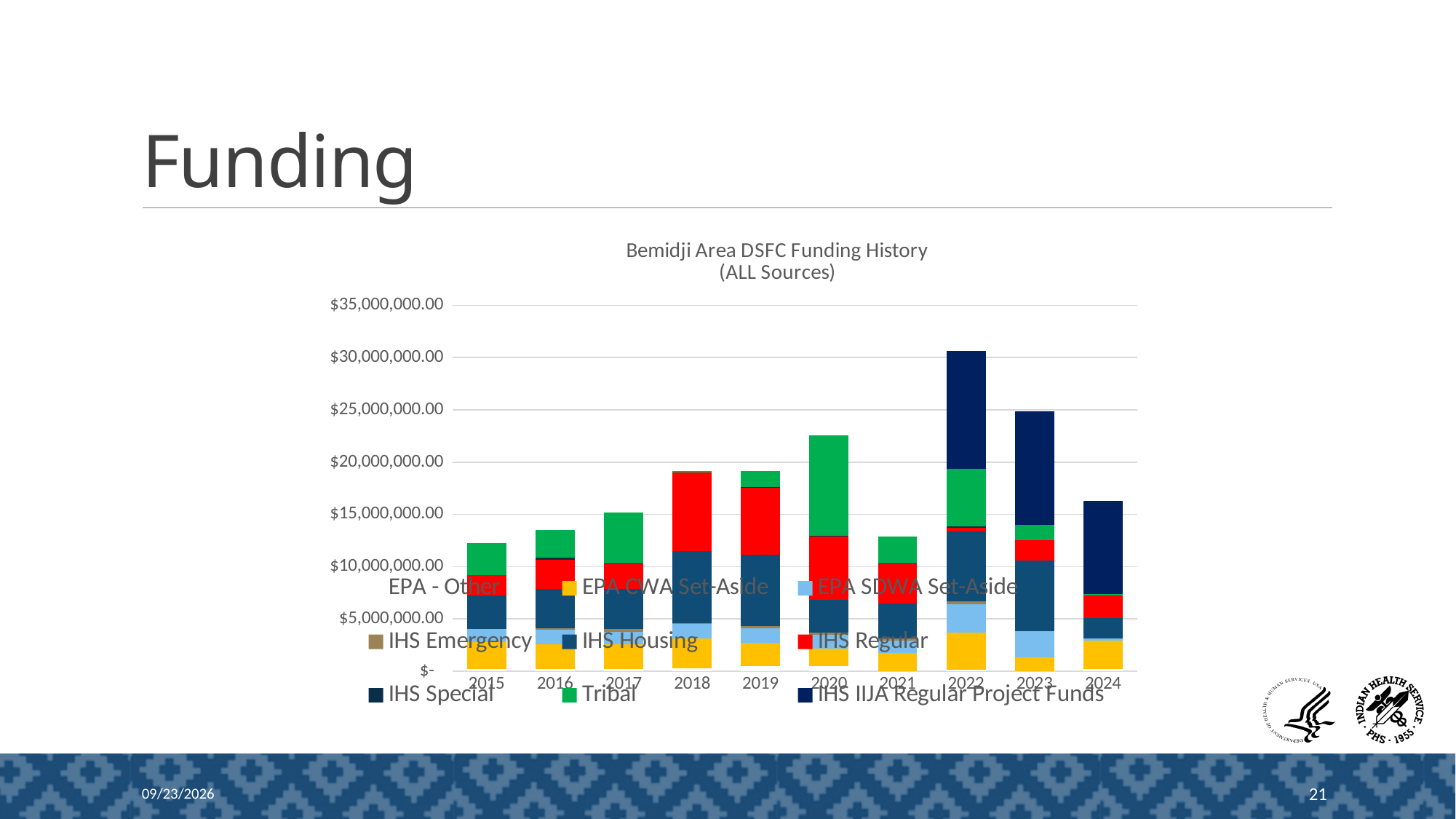
What is the title of the chart? Bemidji Area DSFC Funding History (ALL Sources) Which year has the larger total funding, 2022 or 2023? 2022 Does total funding rise or fall from 2015 to 2018? rise What type of chart is shown on the slide? Stacked bar chart Is the total funding for 2015 greater or less than $15,000,000.00? less Is the total funding for 2020 greater or less than $20,000,000.00? greater How many series does the chart legend list? 9 Is the total funding for 2021 greater or less than $15,000,000.00? less How many years are shown on the x axis of the chart? 10 Which year has the highest total funding? 2022